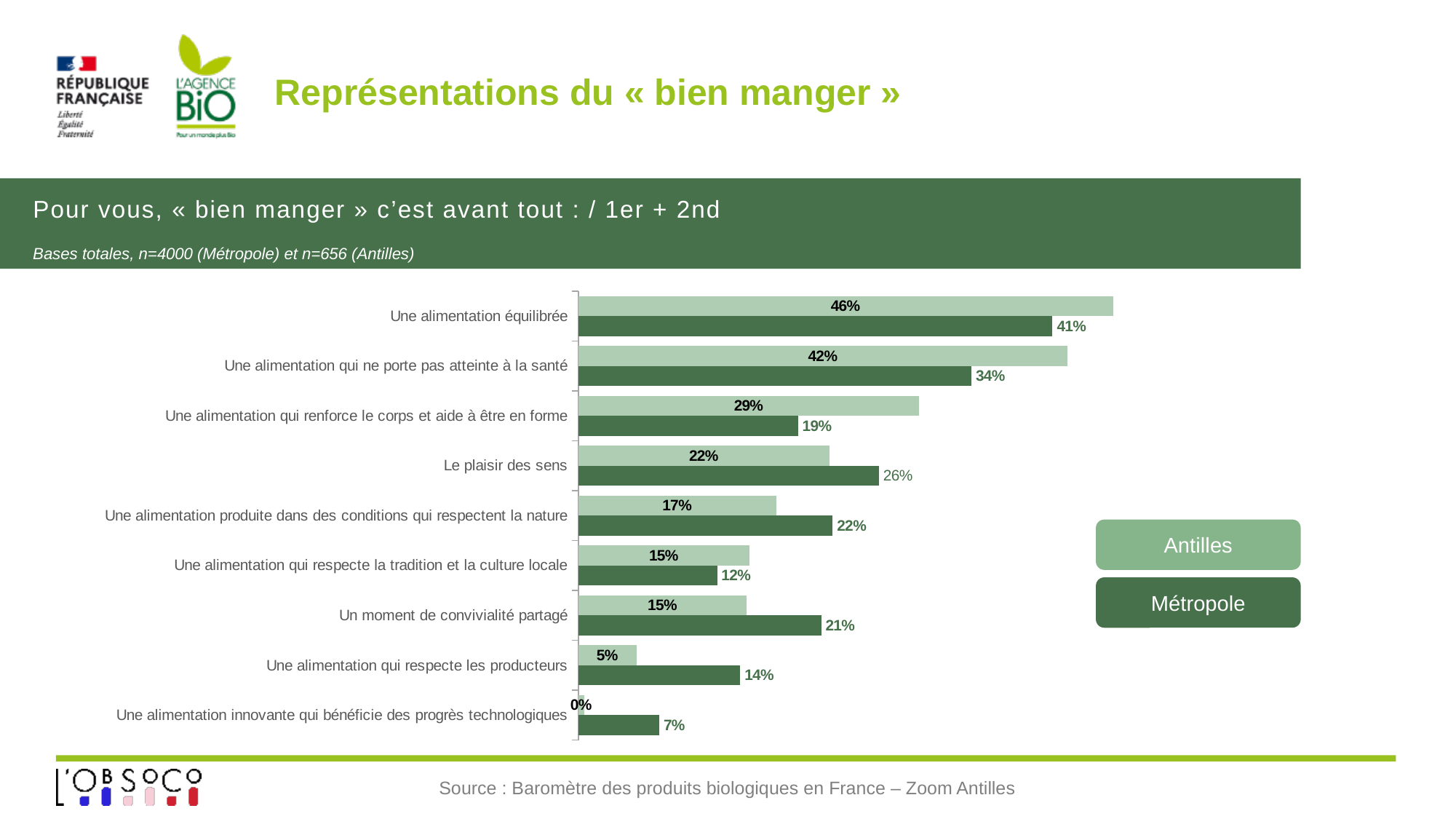
What is the Antilles value for "Une alimentation qui respecte les producteurs"? 5% How many series does the legend list? 2 For "Un moment de convivialité partagé", which is larger: the Antilles value or the Métropole value? Métropole What kind of chart is shown on the slide? Bar chart Which category has the highest Métropole value? Une alimentation équilibrée Which category has the lowest Antilles value? Une alimentation innovante qui bénéficie des progrès technologiques How many categories are shown in the chart? 9 Which series is shown in the darker green colour? Métropole What is the Métropole value for "Une alimentation qui ne porte pas atteinte à la santé"? 34% What is the Antilles value for "Une alimentation équilibrée"? 46% What is the Métropole value for "Le plaisir des sens"? 26% What is the difference between the Antilles and Métropole values for "Une alimentation qui renforce le corps et aide à être en forme"? 10%